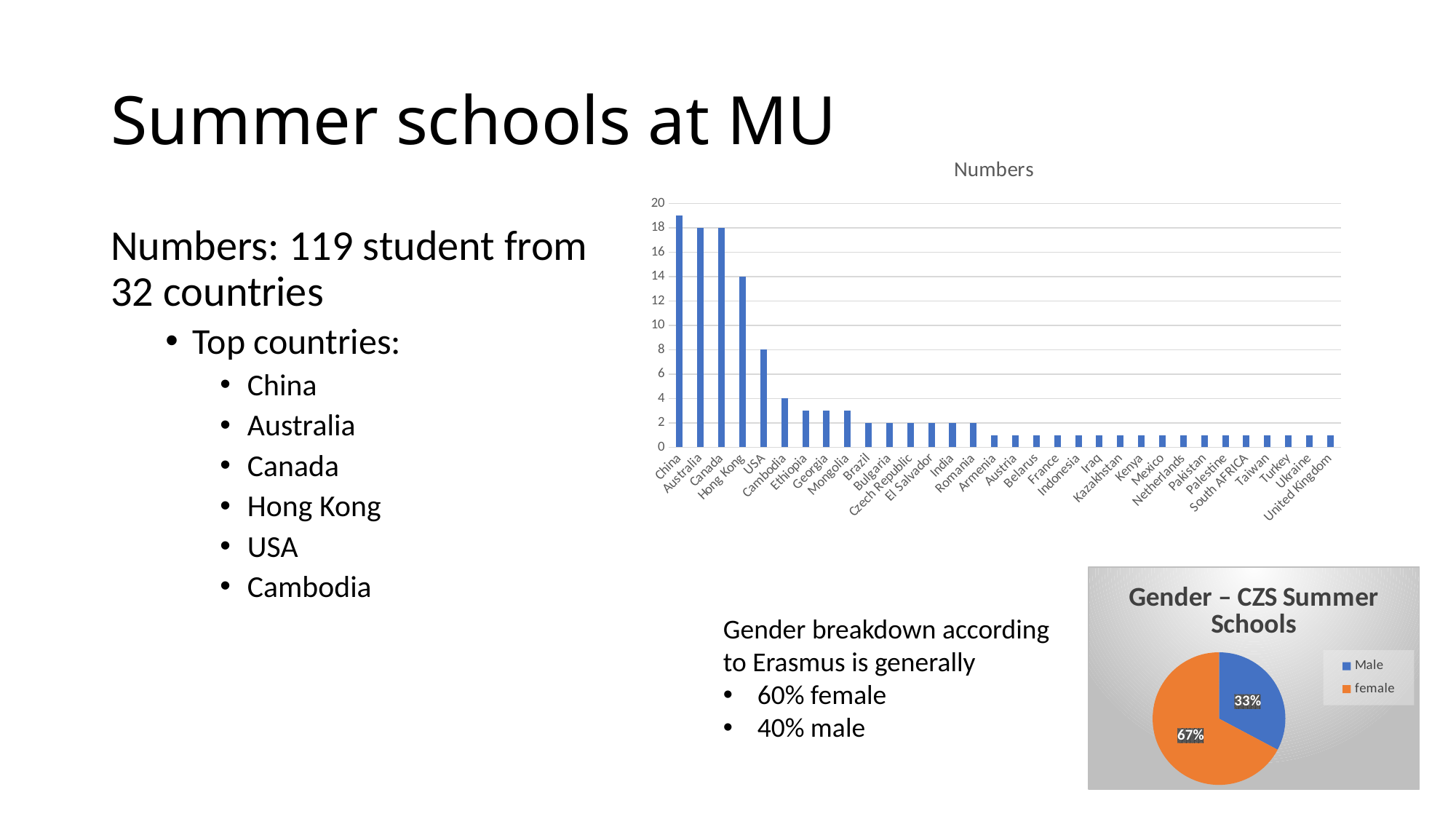
In the 'Numbers' chart, which country has the highest value? China In the 'Numbers' chart, which is larger, the value for Hong Kong or the value for USA? Hong Kong In the 'Gender – CZS Summer Schools' pie chart, what share is female? 67% In the 'Numbers' chart, what is the value for USA? 8 How many entries does the legend of the 'Gender – CZS Summer Schools' chart list? 2 In the 'Numbers' chart, is the value for China greater or less than 18? greater What kind of chart is the 'Numbers' chart? bar chart In the 'Numbers' chart, what is the value for Hong Kong? 14 How many countries are shown in the 'Numbers' chart? 32 In the 'Gender – CZS Summer Schools' pie chart, which slice is the largest? female In the 'Numbers' chart, what is the difference between the values for Hong Kong and USA? 6 In the 'Gender – CZS Summer Schools' pie chart, what share is Male? 33%